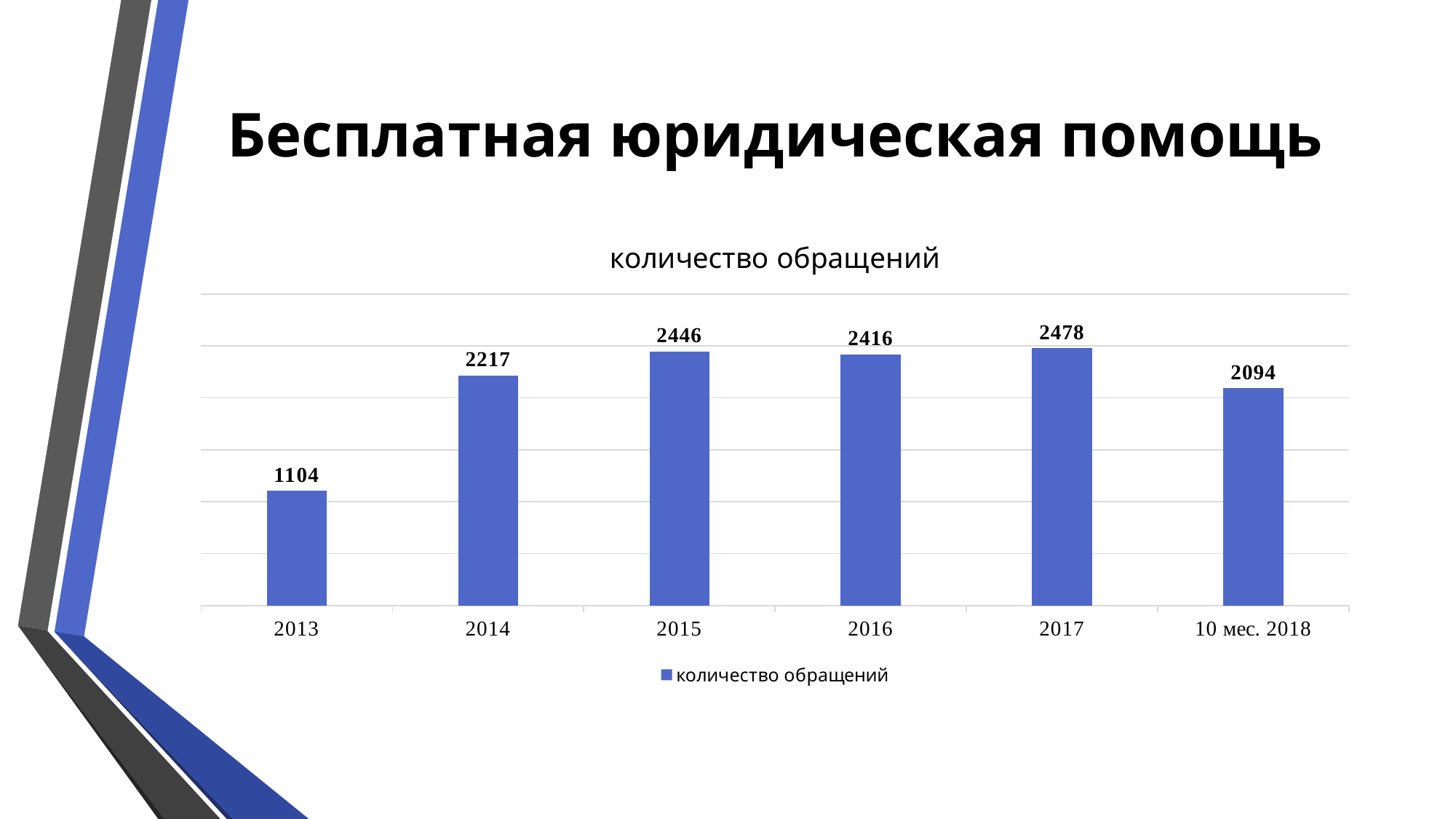
How many series does the legend list? 1 What is the title of the chart? количество обращений Which is larger, the value for 2015 or the value for 2014? 2015 What is the difference between the values for 2014 and 2013? 1113 What is the value for 10 мес. 2018? 2094 What is the difference between the values for 2017 and 10 мес. 2018? 384 Which category has the highest value? 2017 What is the value for 2013? 1104 What is the value for 2016? 2416 How many categories are shown on the x axis? 6 What kind of chart is shown? bar chart Which category has the lowest value? 2013